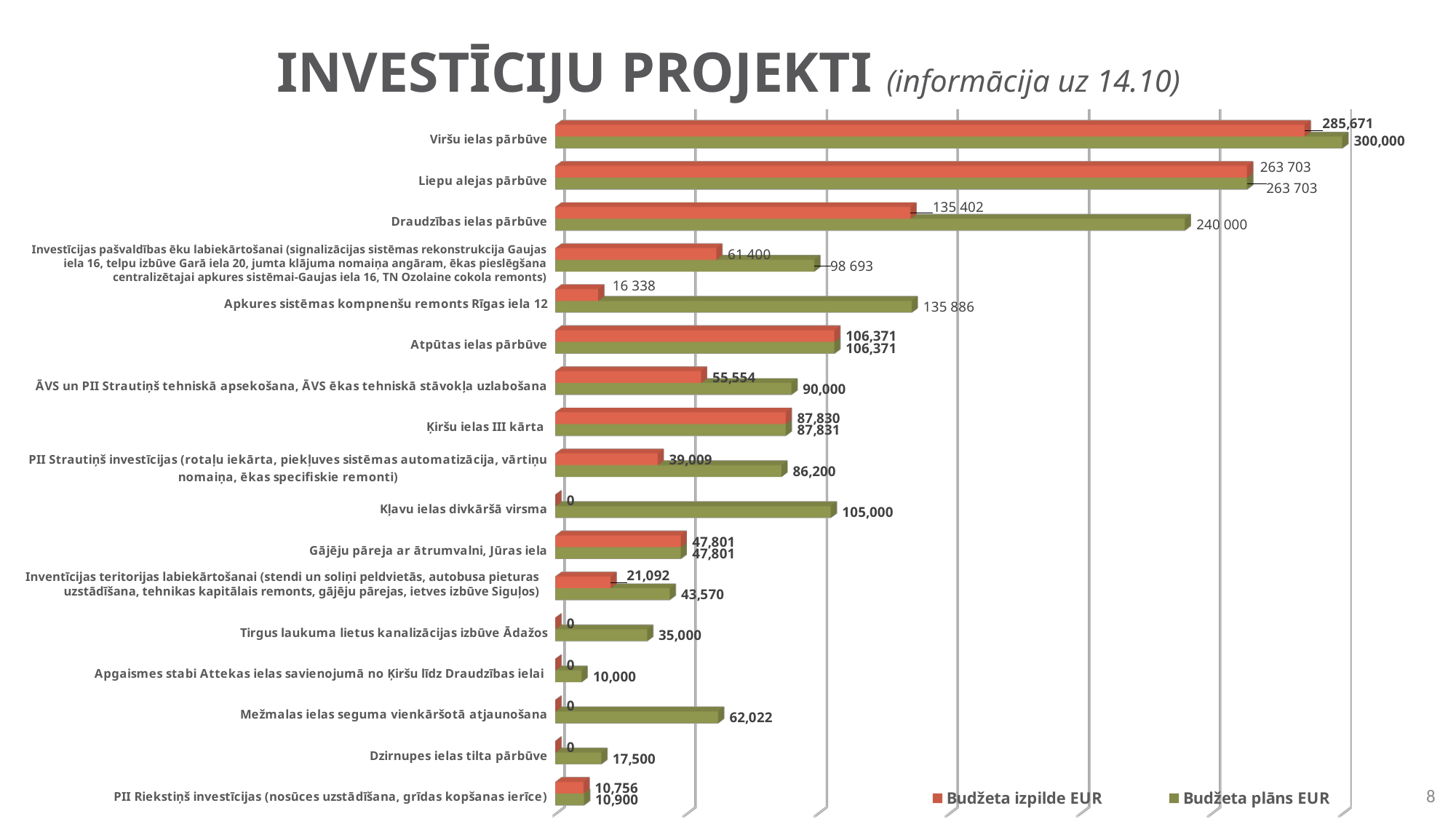
Which project has the lowest Budžeta plāns EUR value? Apgaismes stabi Attekas ielas savienojumā no Ķiršu līdz Draudzības ielai What kind of chart is shown on the slide? bar chart What is the difference between the Budžeta plāns EUR and Budžeta izpilde EUR values for Draudzības ielas pārbūve? 104 598 What is the Budžeta plāns EUR value for Viršu ielas pārbūve? 300,000 How many series does the legend list? 2 How many projects (categories) are shown in the chart? 17 Which project has the highest Budžeta plāns EUR value? Viršu ielas pārbūve What is the Budžeta izpilde EUR value for Draudzības ielas pārbūve? 135 402 Which colour represents the Budžeta izpilde EUR series? red What is the difference between the Budžeta plāns EUR and Budžeta izpilde EUR values for Viršu ielas pārbūve? 14,329 Which is larger for Apkures sistēmas kompnenšu remonts Rīgas iela 12: Budžeta izpilde EUR or Budžeta plāns EUR? Budžeta plāns EUR What is the Budžeta plāns EUR value for Kļavu ielas divkāršā virsma? 105,000